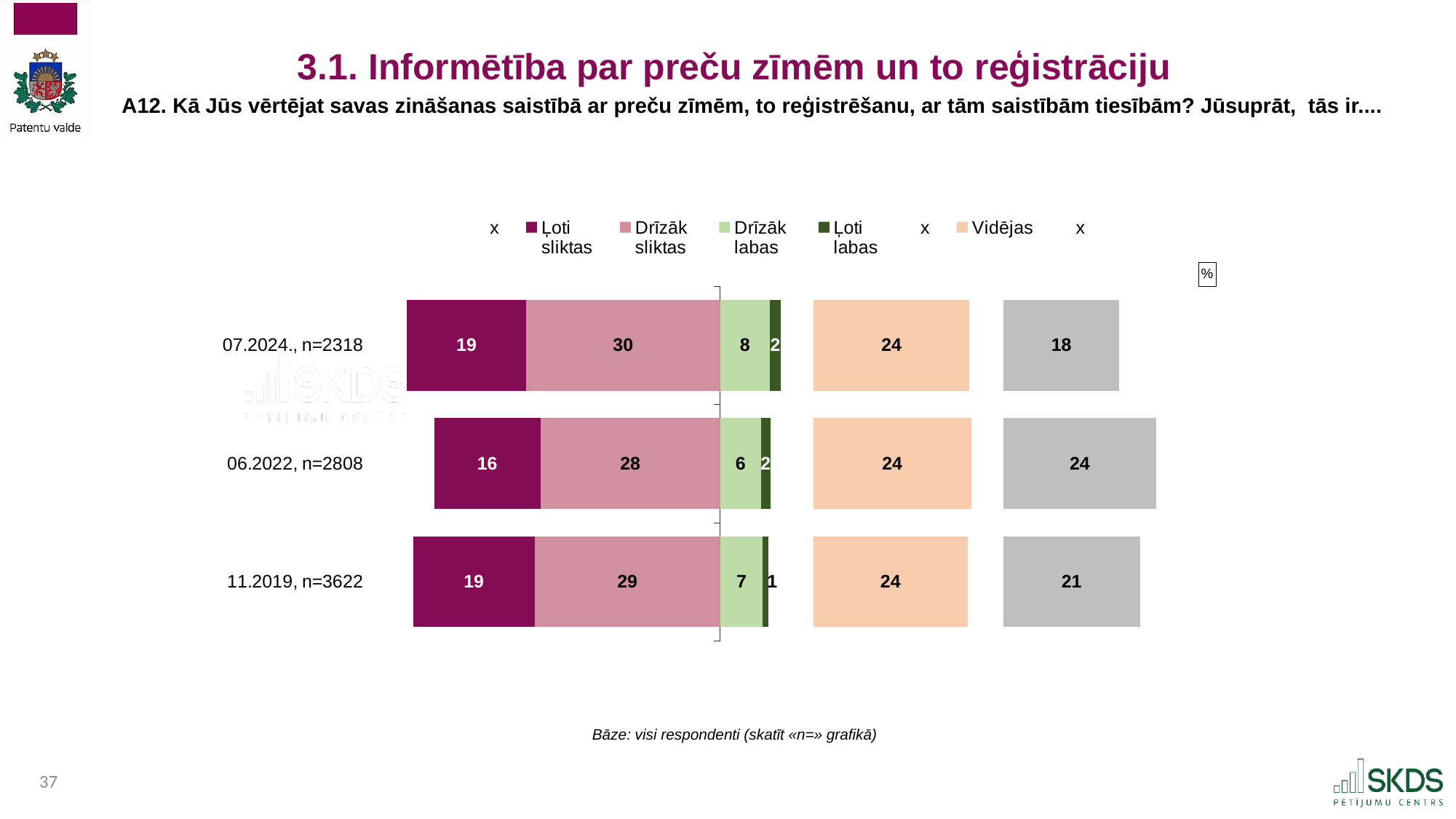
Which row has the highest value for "Drīzāk sliktas"? 07.2024., n=2318 What is the total of "Ļoti sliktas" and "Drīzāk sliktas" for the 11.2019, n=3622 row? 48 What is the value for "Drīzāk sliktas" in the 06.2022, n=2808 row? 28 Which row has the lowest value for "Ļoti sliktas"? 06.2022, n=2808 What is the difference between the "Drīzāk labas" values for 07.2024., n=2318 and 06.2022, n=2808? 2 What kind of chart is shown on the slide? Stacked bar chart What is the value for "Ļoti labas" in the 06.2022, n=2808 row? 2 Is the "Ļoti sliktas" value larger for 07.2024., n=2318 or for 06.2022, n=2808? 07.2024., n=2318 What is the value for "Ļoti sliktas" in the 07.2024., n=2318 row? 19 What is the value for "Drīzāk labas" in the 11.2019, n=3622 row? 7 What is the value for "Vidējas" in the 07.2024., n=2318 row? 24 How many survey rows (categories) are shown in the chart? 3